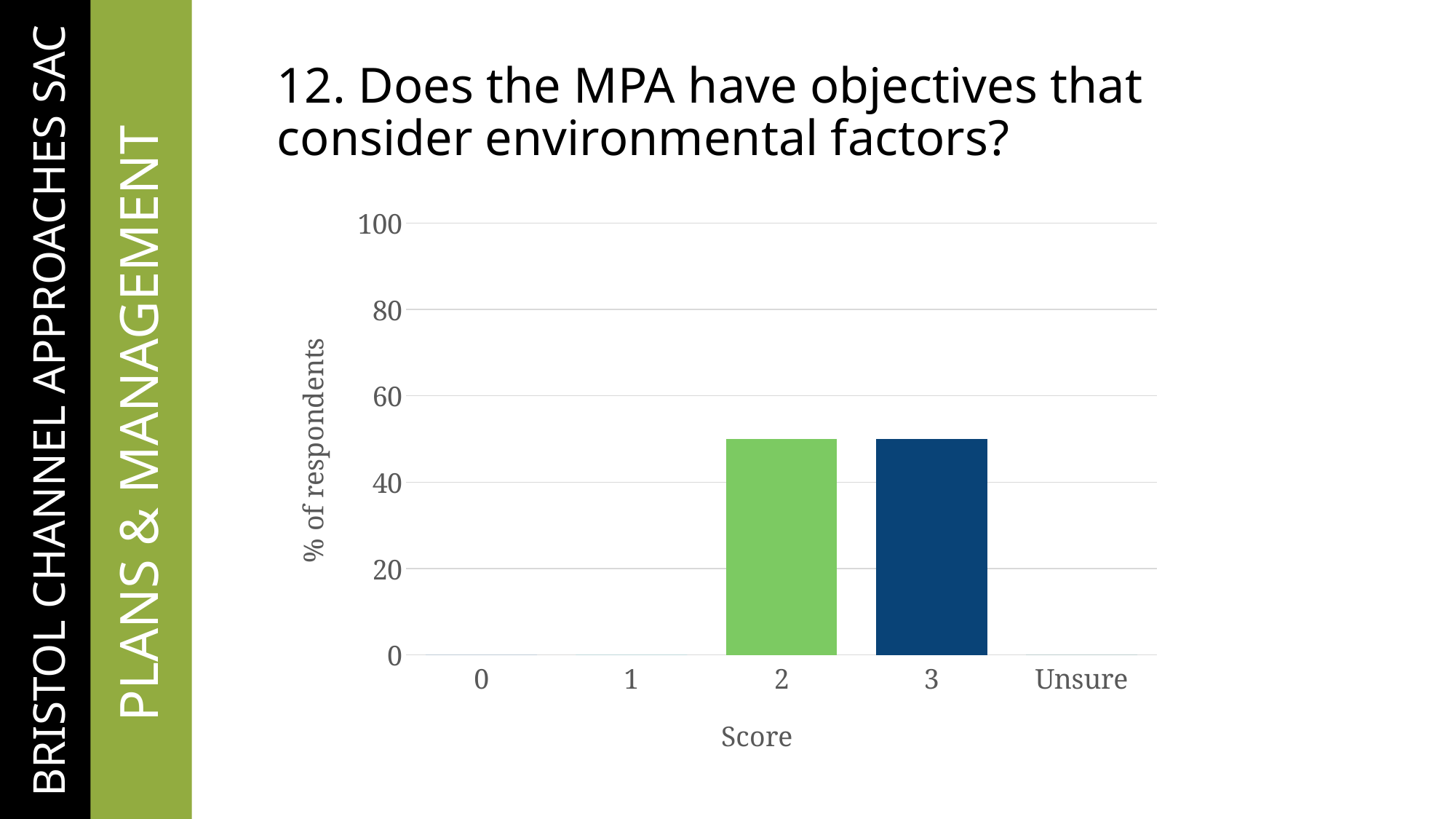
What kind of chart is shown on the slide? bar chart Is the value for score 0 greater or less than 20? less Is the value for score 2 greater or less than 40? greater How many score categories are shown on the x axis of the chart? 5 What is the label on the x axis of the chart? Score Is the value for score 3 greater or less than 40? greater What is the label on the y axis of the chart? % of respondents